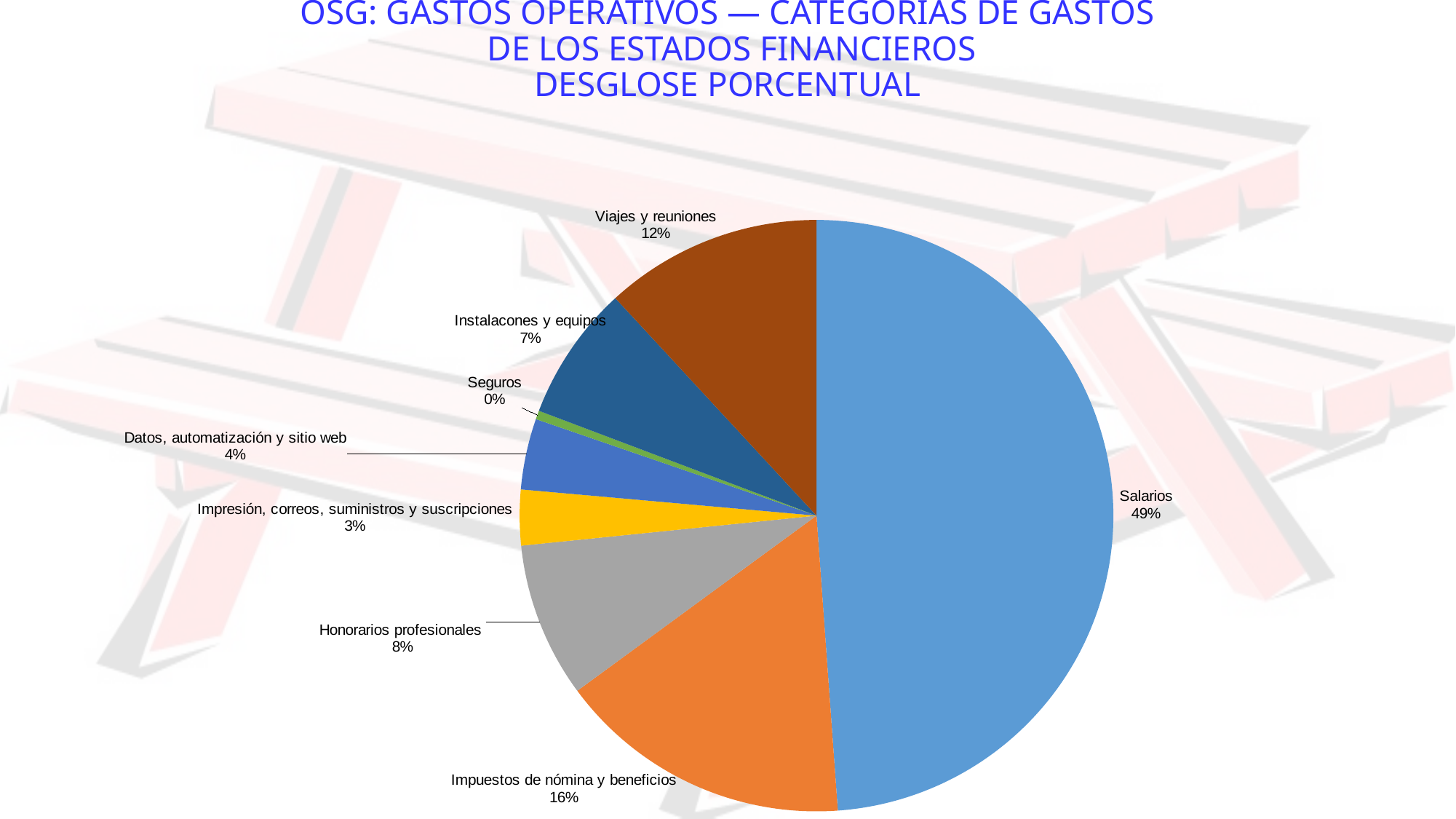
Which category has the smallest share of the pie? Seguros Which category has the largest share of the pie? Salarios What is the combined share of Viajes y reuniones and Instalacones y equipos? 19% How many categories are shown in the pie chart? 8 What percentage is shown for Seguros? 0% What percentage is shown for Impuestos de nómina y beneficios? 16% What share of the pie does Salarios represent? 49% What type of chart is shown on the slide? Pie chart What percentage is shown for Honorarios profesionales? 8% What percentage is shown for Viajes y reuniones? 12% What is the difference in percentage points between Salarios and Impuestos de nómina y beneficios? 33 Which is larger, Instalacones y equipos or Datos, automatización y sitio web? Instalacones y equipos